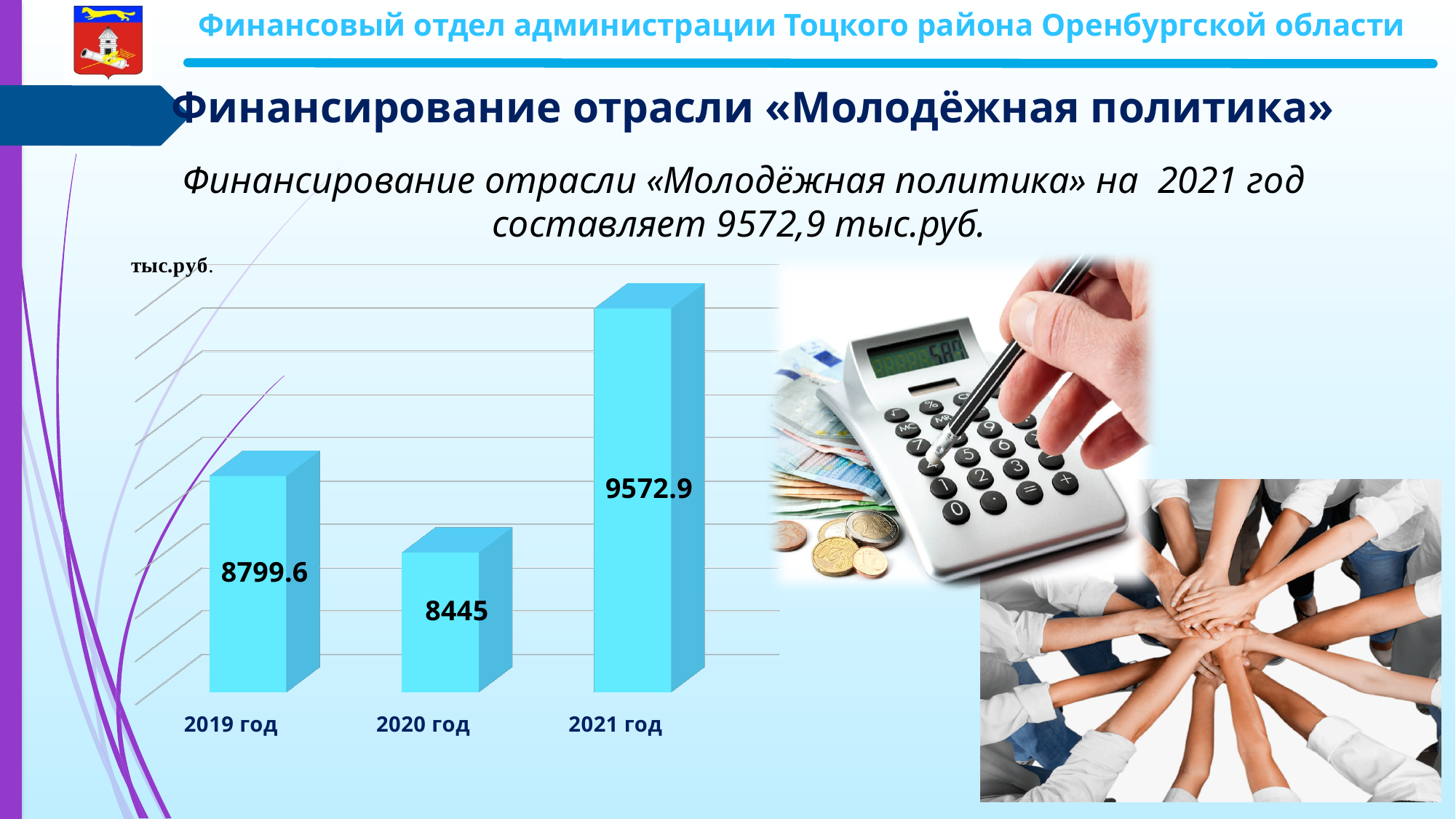
What is the difference between the values for 2021 год and 2020 год? 1127.9 What is the difference between the values for 2019 год and 2020 год? 354.6 Which year has the lowest value? 2020 год Which is larger, the value for 2019 год or the value for 2020 год? 2019 год What is the value for 2019 год? 8799.6 What is the value for 2021 год? 9572.9 What unit is indicated above the chart's vertical axis? тыс.руб. What is the difference between the values for 2021 год and 2019 год? 773.3 What kind of chart is shown on the slide? bar chart How many years are shown in the chart? 3 What is the value for 2020 год? 8445 Which year has the highest value? 2021 год